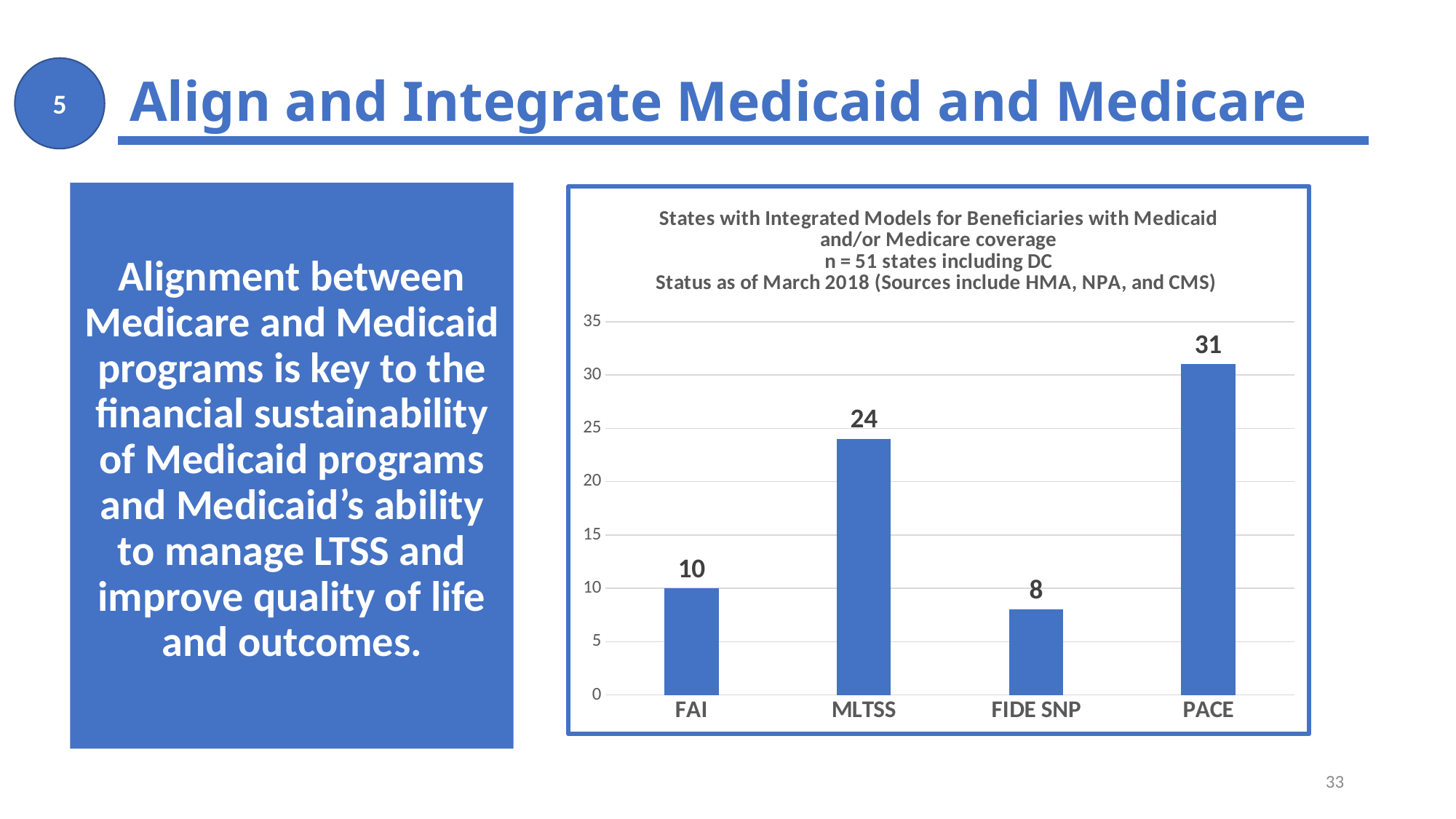
Which is larger, the value for FAI or the value for FIDE SNP? FAI What is the value for FIDE SNP? 8 What kind of chart is shown on the slide? bar chart Which category has the highest value? PACE What is the value for PACE? 31 Is the value for MLTSS greater or less than 20? greater According to the chart title, how many states are included (n)? 51 states including DC How many categories are shown on the x axis? 4 Which category has the lowest value? FIDE SNP What is the difference between the values for PACE and MLTSS? 7 What is the value for FAI? 10 What is the value for MLTSS? 24